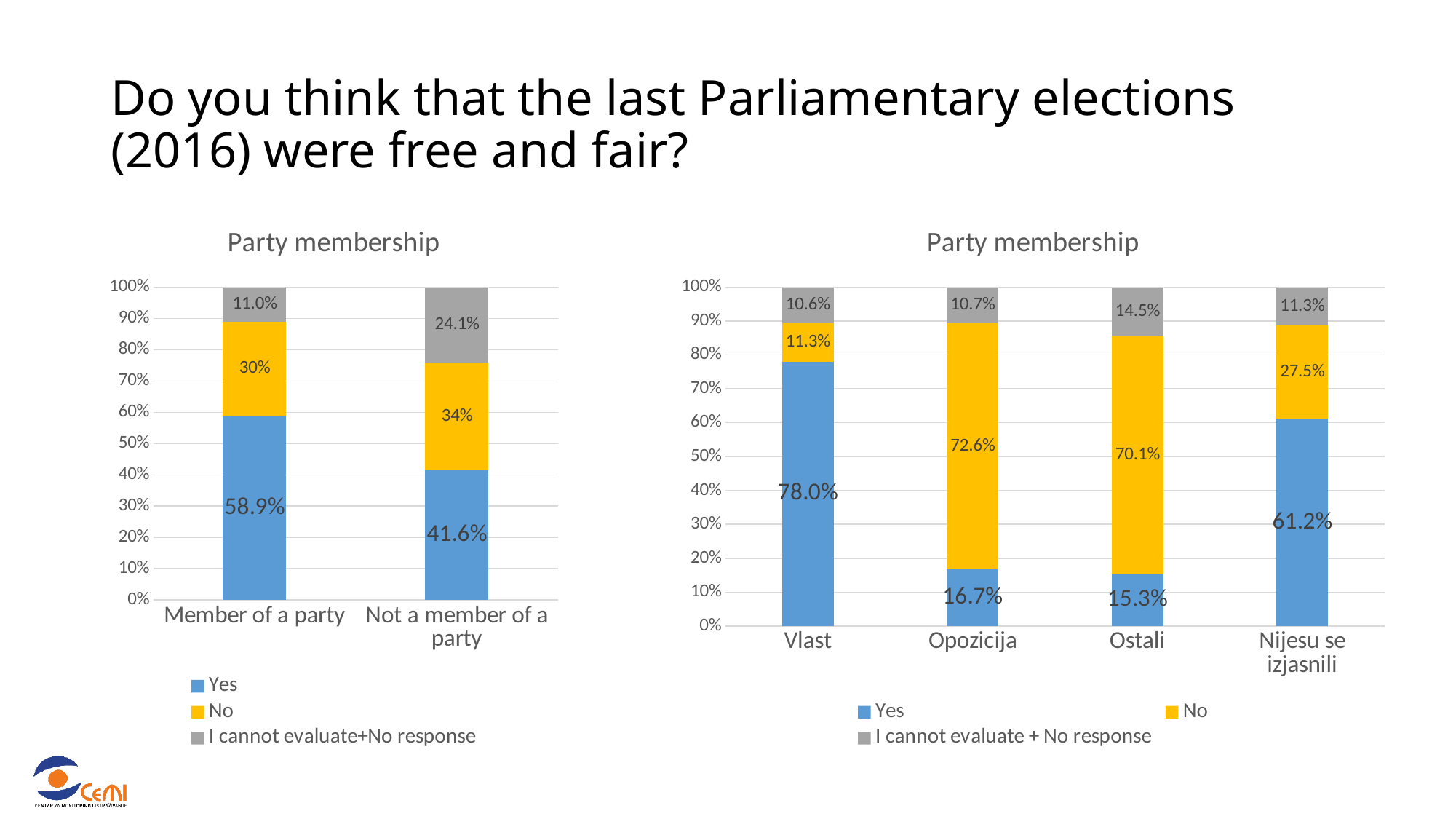
In the right chart, which category has the lowest Yes value? Ostali How many categories are shown on the x axis of the right chart? 4 In the right chart, what is the Yes value for Vlast? 78.0% In the right chart, what is the No value for Opozicija? 72.6% What type of chart is the right chart? Stacked bar chart In the left chart, what percentage of members of a party answered Yes? 58.9% In the right chart, which is larger: the No value for Ostali or the No value for Nijesu se izjasnili? Ostali In the right chart, which category has the highest Yes value? Vlast In the left chart, what is the difference between the Yes values for 'Member of a party' and 'Not a member of a party'? 17.3% How many series does the legend of the left chart list? 3 In the right chart, what is the 'I cannot evaluate + No response' value for Ostali? 14.5% In the left chart, what is the 'I cannot evaluate+No response' value for 'Not a member of a party'? 24.1%